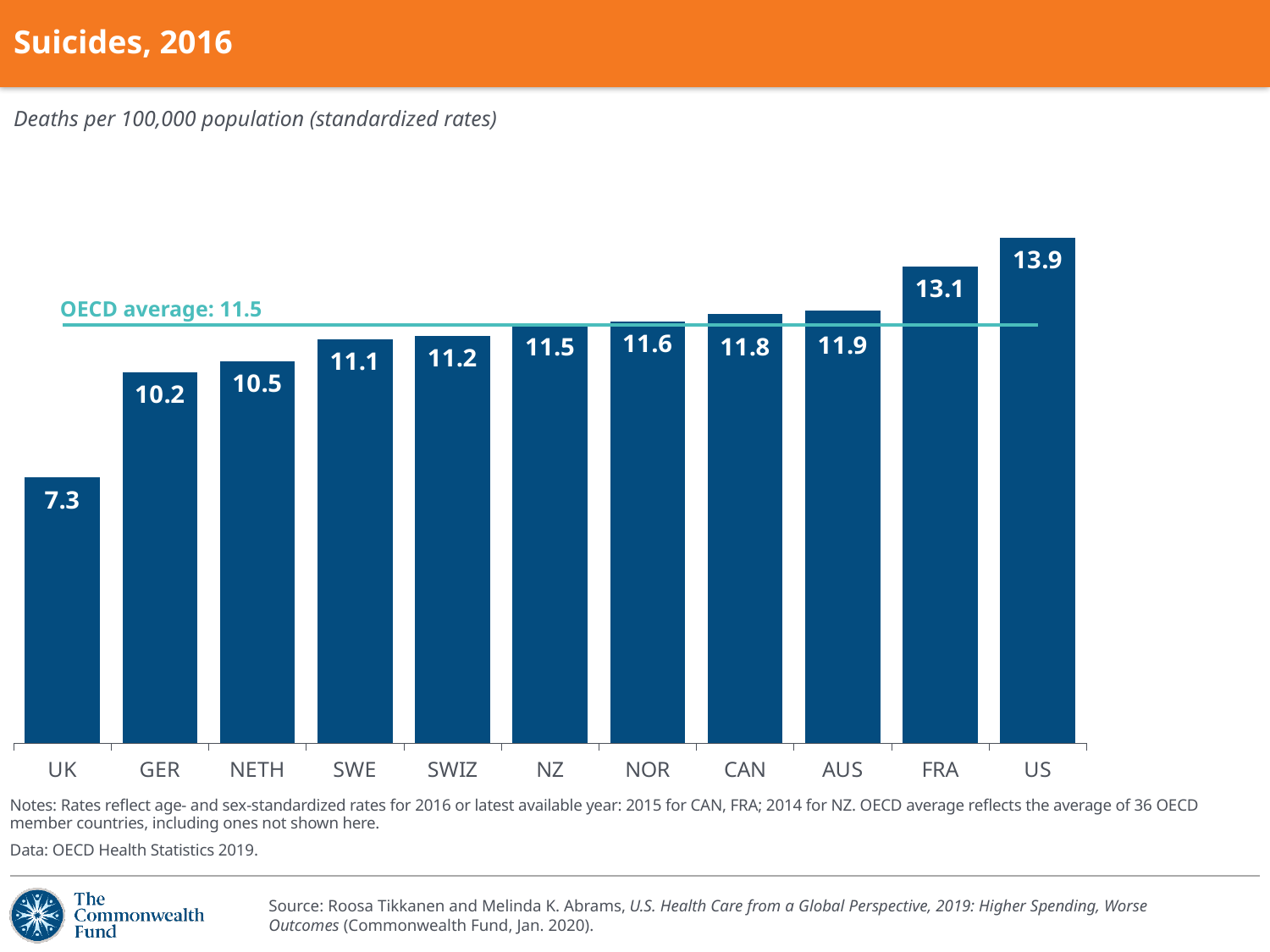
What OECD average value is marked by the horizontal line on the chart? 11.5 Which country has the lowest suicide rate on the chart? UK What is the suicide rate for the UK? 7.3 What is the difference between the values for FRA and AUS? 1.2 Do the values rise or fall from left to right across the chart? Rise Which has a higher value, GER or NETH? NETH What is the difference between the values for US and UK? 6.6 What is the value shown for FRA? 13.1 What is the value shown for SWIZ? 11.2 Which country has the highest suicide rate on the chart? US How many countries are shown on the chart? 11 What kind of chart is shown on the slide? Bar chart